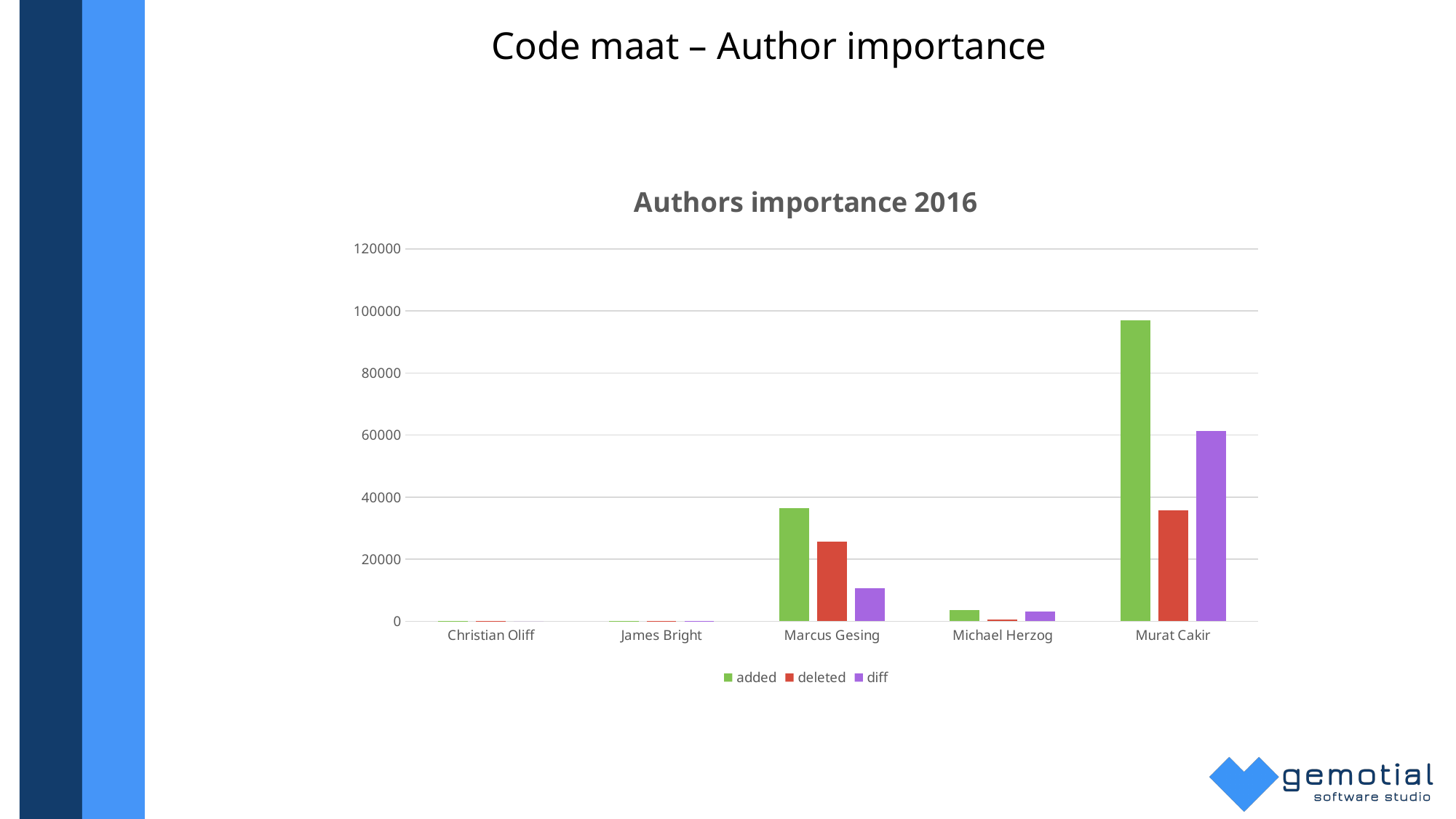
Is the 'added' value for Murat Cakir greater or less than 80000? greater Is the 'added' value for Michael Herzog greater or less than 20000? less Which author has the highest 'added' value? Murat Cakir How many authors are shown on the x axis of the chart? 5 What is the title of the chart? Authors importance 2016 Is the 'deleted' value for Marcus Gesing greater or less than 20000? greater What kind of chart is shown on the slide? bar chart How many series does the chart's legend list? 3 For Marcus Gesing, which is larger: the 'added' value or the 'deleted' value? added Which author has the highest 'diff' value? Murat Cakir Which colour represents the 'deleted' series in the chart? red